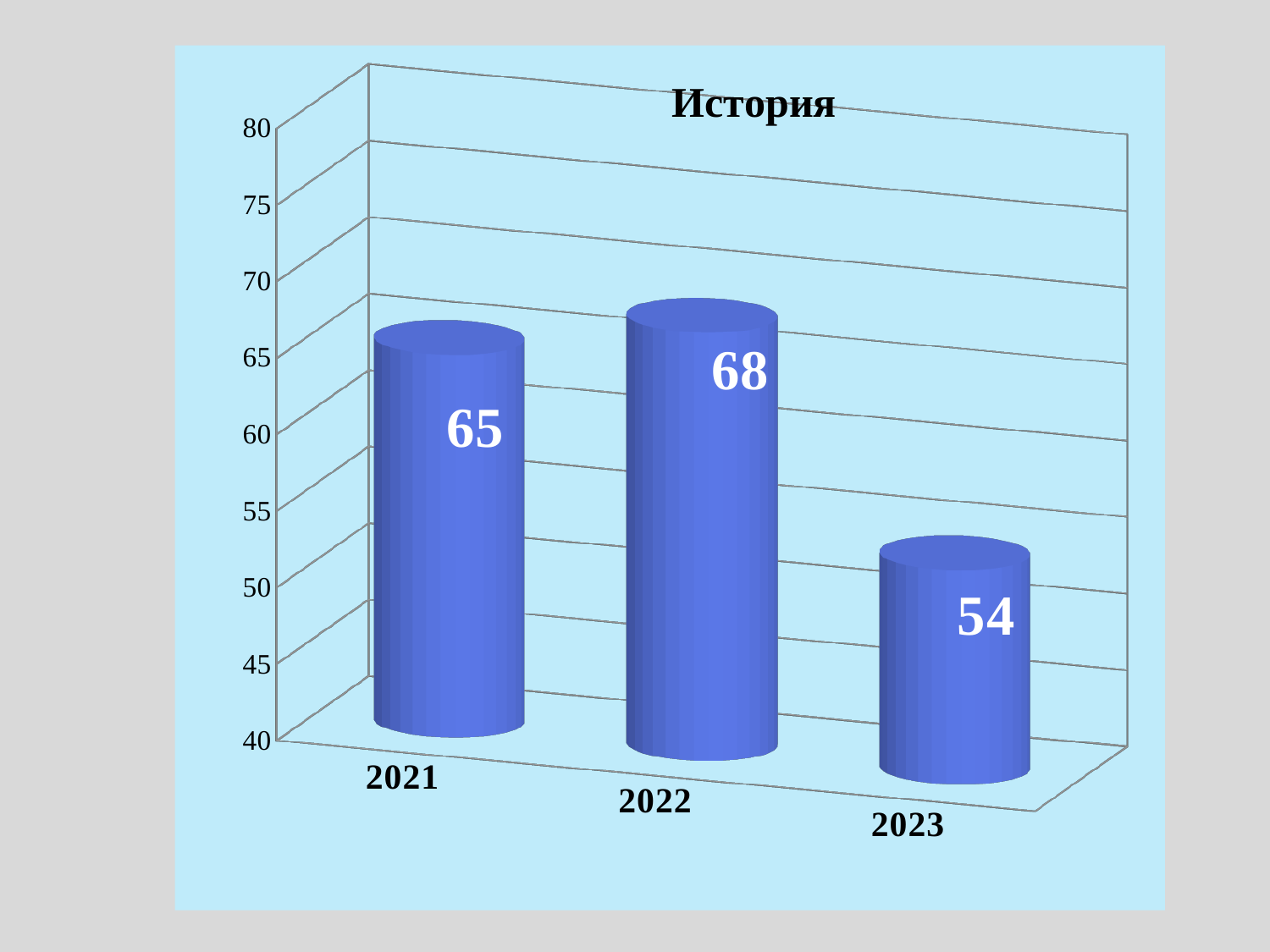
What is the difference between the values for 2021 and 2023? 11 What is the title of the chart? История What is the difference between the values for 2022 and 2023? 14 What kind of chart is shown on the slide? bar chart What is the value for 2022? 68 Is the value for 2023 greater or less than 60? less Which year has the highest value? 2022 What is the value for 2021? 65 Which year has the lowest value? 2023 What is the value for 2023? 54 Which is larger, the value for 2021 or the value for 2023? 2021 How many years are shown on the chart? 3